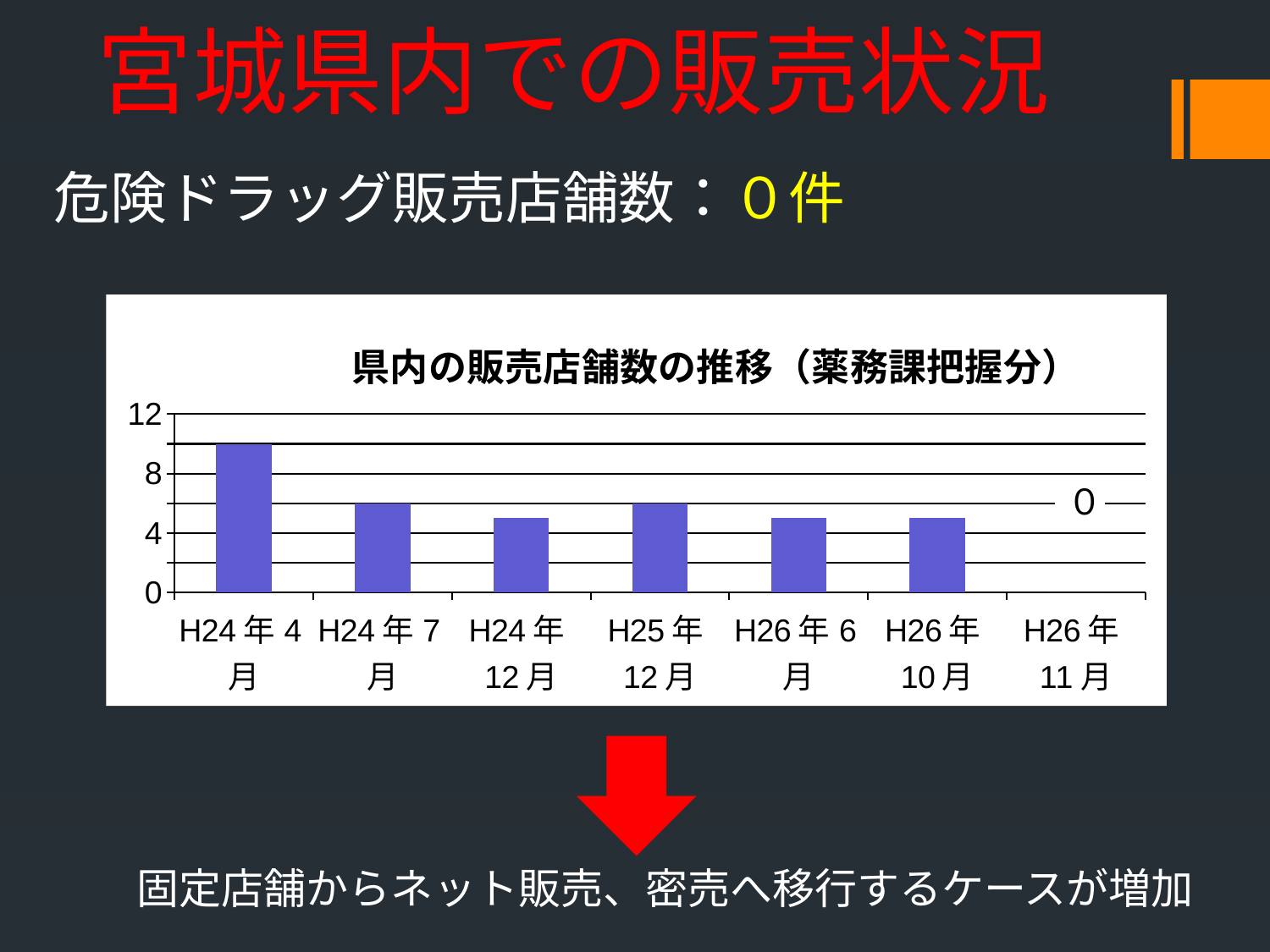
Which category has the lowest value? H26年11月 What kind of chart is shown on the slide? bar chart How many categories are shown on the x axis of the chart? 7 Which is larger, the value for H24年4月 or the value for H25年12月? H24年4月 Is the value for H24年12月 greater or less than 4? greater Is the value for H24年7月 greater or less than 8? less What is the title of the chart? 県内の販売店舗数の推移（薬務課把握分） Do the values generally rise or fall from H24年4月 to H26年11月? fall What is the value for H26年11月? 0 Which category has the highest value? H24年4月 Is the value for H24年4月 greater or less than 8? greater Which is larger, the value for H26年10月 or the value for H26年11月? H26年10月